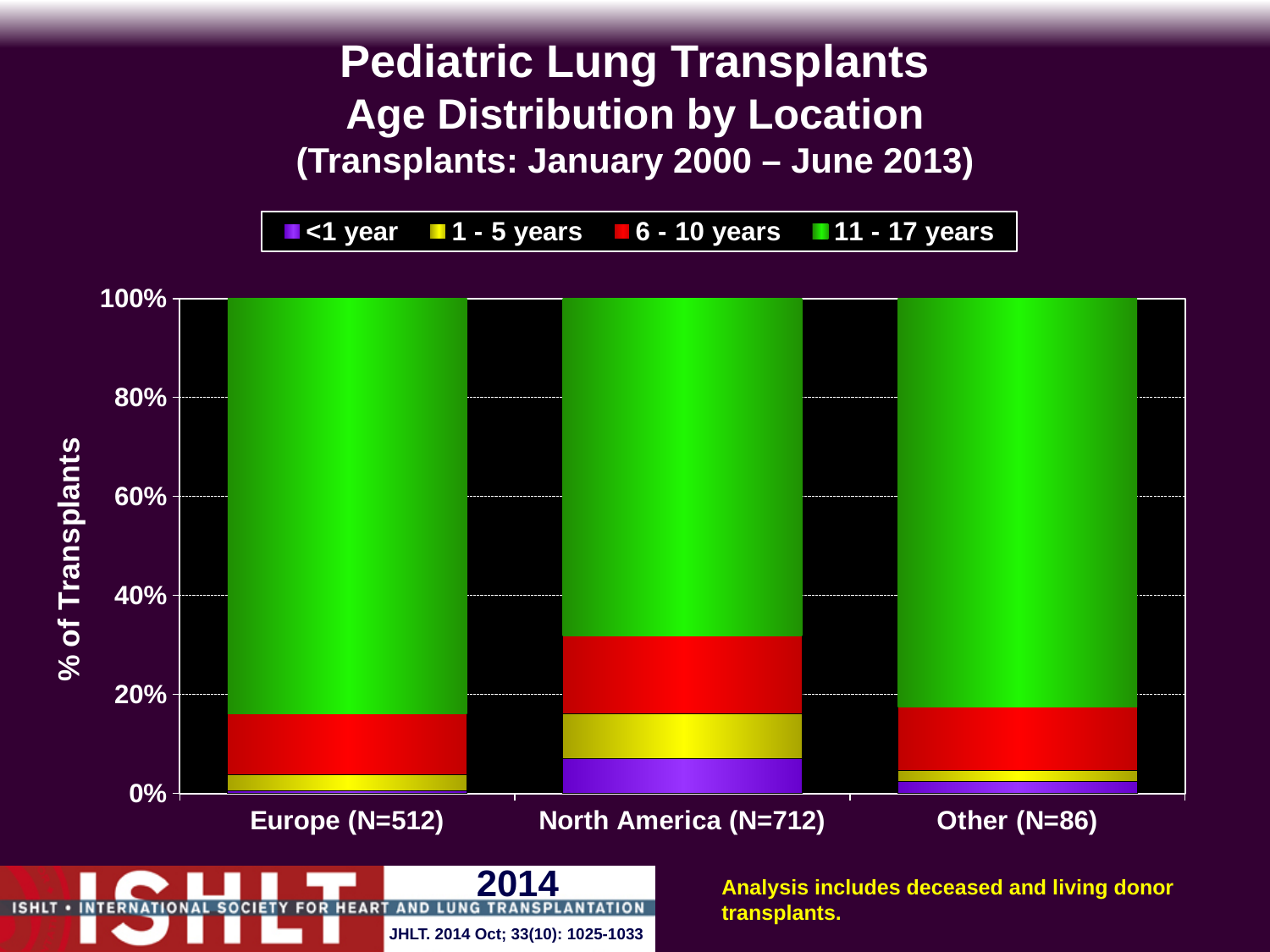
Is the 11 - 17 years share for North America greater or less than 60%? greater Is the 6 - 10 years segment larger for Europe or for North America? North America Which location has the largest share of transplants in the 1 - 5 years age group? North America (N=712) Which location has the largest share of transplants in the <1 year age group? North America (N=712) How many locations are shown on the x axis? 3 What kind of chart is shown on the slide? Stacked bar chart How many age groups does the legend list? 4 Which location has the smallest share of transplants in the 11 - 17 years age group? North America (N=712) Is the 11 - 17 years share for Europe greater or less than 80%? greater What is the label on the y axis? % of Transplants What is the N shown for Europe in its category label? 512 Is the 11 - 17 years share for North America greater or less than 80%? less